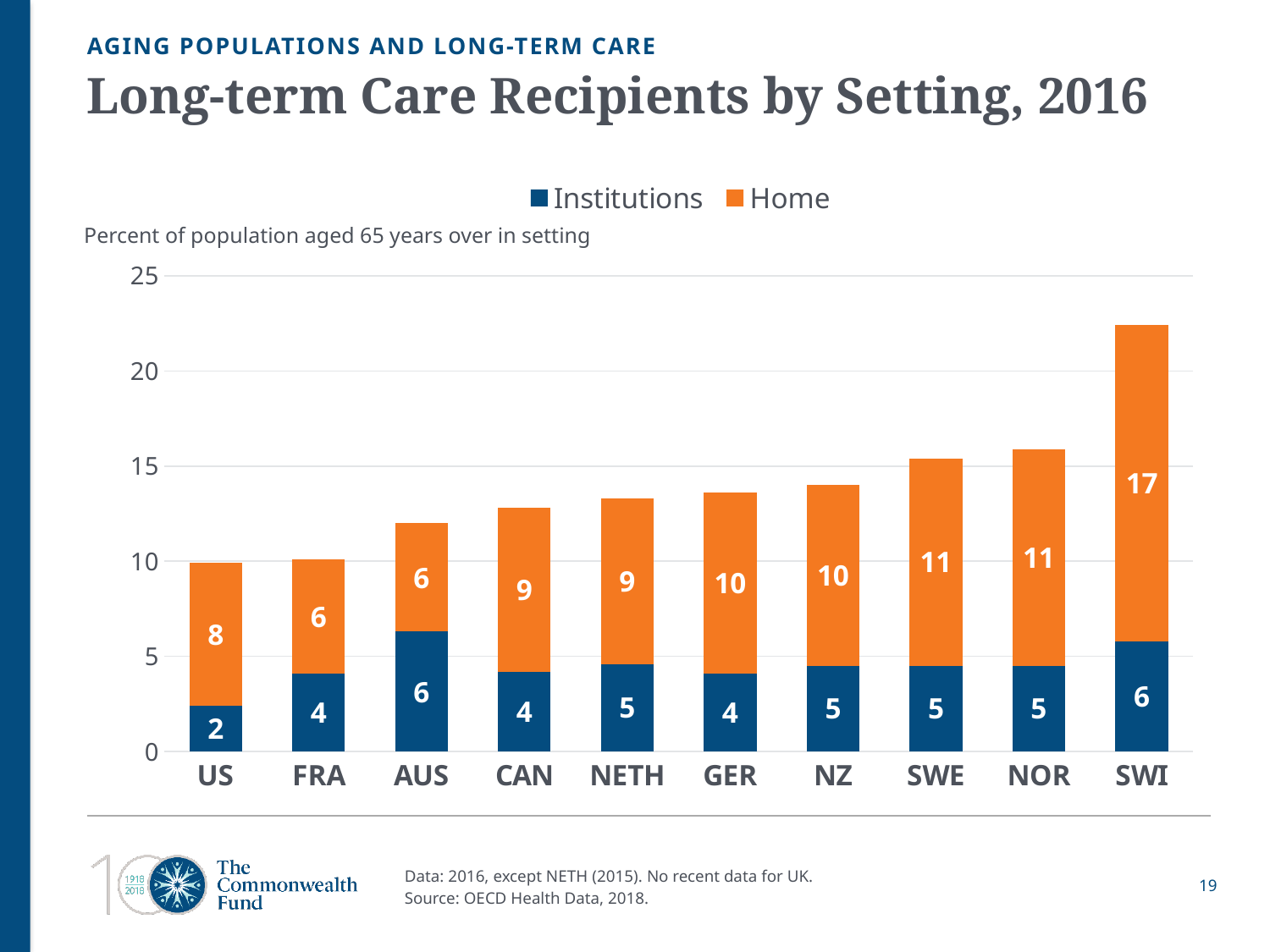
Is the total height of the SWI bar greater or less than 20? greater Which is larger, the Home value for GER or the Home value for FRA? GER How many series does the legend list? 2 Do the total bar heights generally rise or fall from left to right across the countries? rise How many countries are shown on the x axis? 10 Which country has the lowest Institutions value? US What is the Home value for Switzerland (SWI)? 17 What kind of chart is shown on the slide? stacked bar chart What is the Institutions value for the US? 2 What is the difference between the Home value for SWI and the Home value for US? 9 What is the Home value for Canada (CAN)? 9 Which country has the highest Home value? SWI